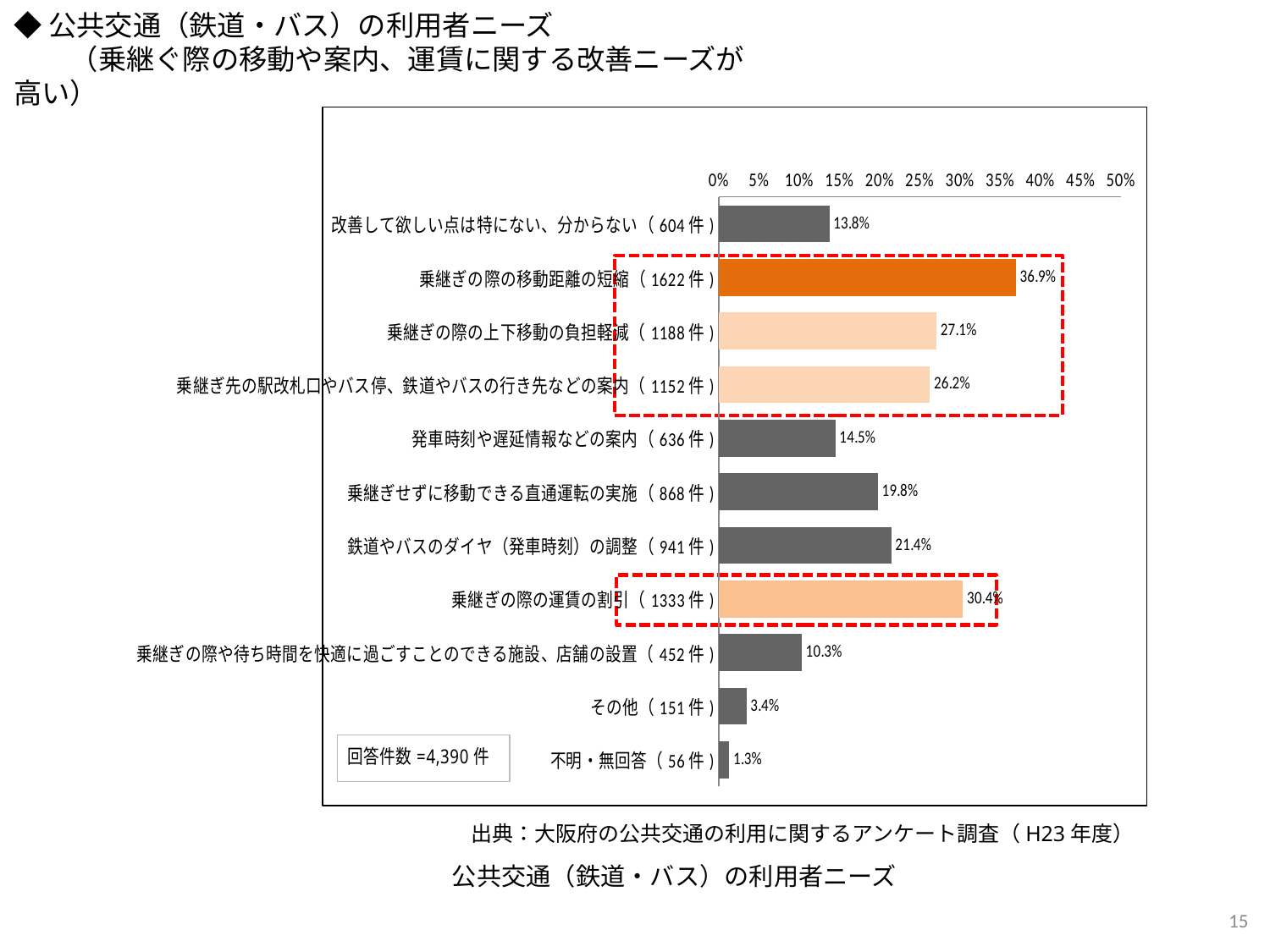
「乗継ぎせずに移動できる直通運転の実施」の値は20％より大きいですか、小さいですか？ 小さい 「その他」の回答件数は何件ですか？ 151件 「乗継ぎの際の移動距離の短縮」と「乗継ぎの際の運賃の割引」の値の差は何ポイントですか？ 6.5ポイント グラフ内に示されている回答件数の合計は何件ですか？ 4,390件 「乗継ぎの際の運賃の割引」の値は何％ですか？ 30.4% グラフには項目がいくつありますか？ 11 「乗継ぎの際の移動距離の短縮」の値は何％ですか？ 36.9% 最も値が高い項目はどれですか？ 乗継ぎの際の移動距離の短縮 「乗継ぎの際の上下移動の負担軽減」と「鉄道やバスのダイヤ（発車時刻）の調整」では、どちらの値が大きいですか？ 乗継ぎの際の上下移動の負担軽減 「発車時刻や遅延情報などの案内」の値は何％ですか？ 14.5% このグラフはどの種類のグラフですか？ 棒グラフ 最も値が低い項目はどれですか？ 不明・無回答